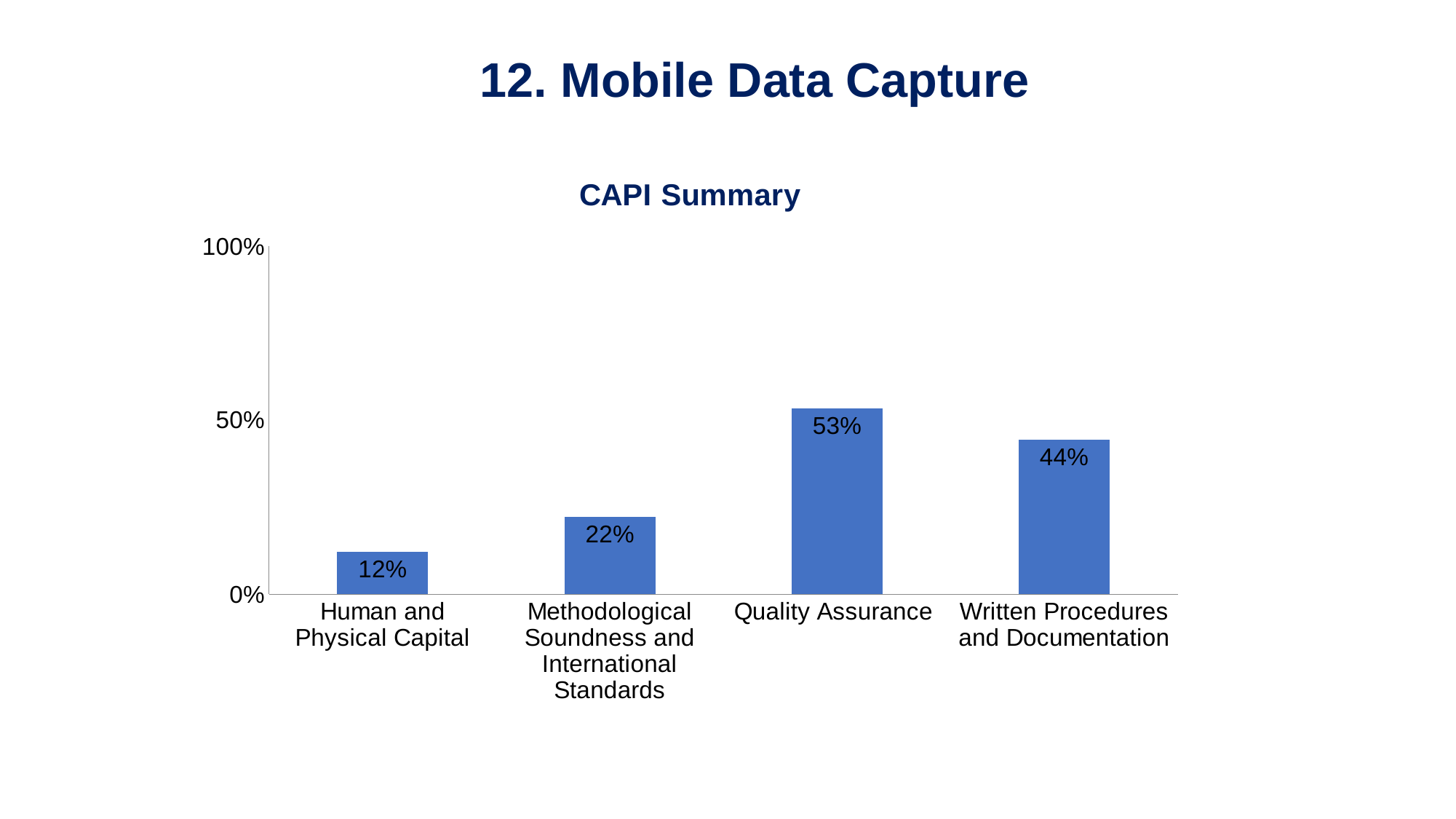
Which category has the lowest value? Human and Physical Capital What kind of chart is shown on the slide? bar chart Which category has the highest value? Quality Assurance What is the value for Human and Physical Capital? 12% What is the value for Methodological Soundness and International Standards? 22% How many categories are shown on the chart? 4 What is the value for Written Procedures and Documentation? 44% What is the value for Quality Assurance? 53% What is the title of the chart? CAPI Summary Which is larger, the value for Methodological Soundness and International Standards or the value for Written Procedures and Documentation? Written Procedures and Documentation What is the difference between the values for Quality Assurance and Written Procedures and Documentation? 9% Is the value for Quality Assurance greater or less than 50%? greater